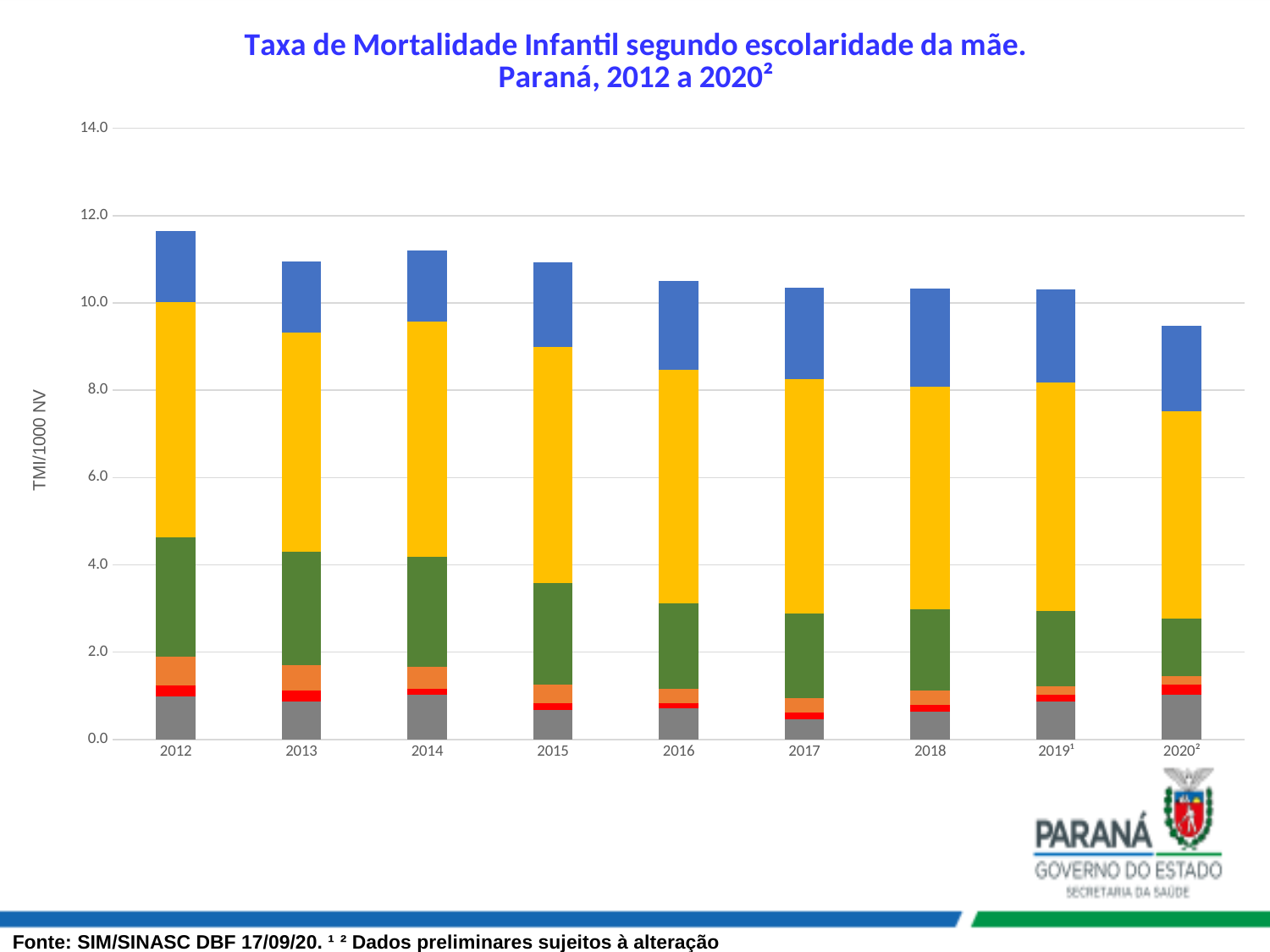
Is the total height of the bar for 2020² greater or less than 10.0? less Do the total bar heights generally rise or fall from 2012 to 2020²? Fall Which year has the tallest stacked bar (highest total infant mortality rate)? 2012 Is the total height of the bar for 2012 greater or less than 10.0? greater What kind of chart is shown on the slide? Stacked bar chart What is the title of the chart? Taxa de Mortalidade Infantil segundo escolaridade da mãe. Paraná, 2012 a 2020² Which year has the shortest stacked bar (lowest total infant mortality rate)? 2020² How many years (categories) are shown on the x axis? 9 Is the total height of the bar for 2016 greater or less than 10.0? greater What is the label of the vertical axis? TMI/1000 NV Which bar is taller in total, 2012 or 2020²? 2012